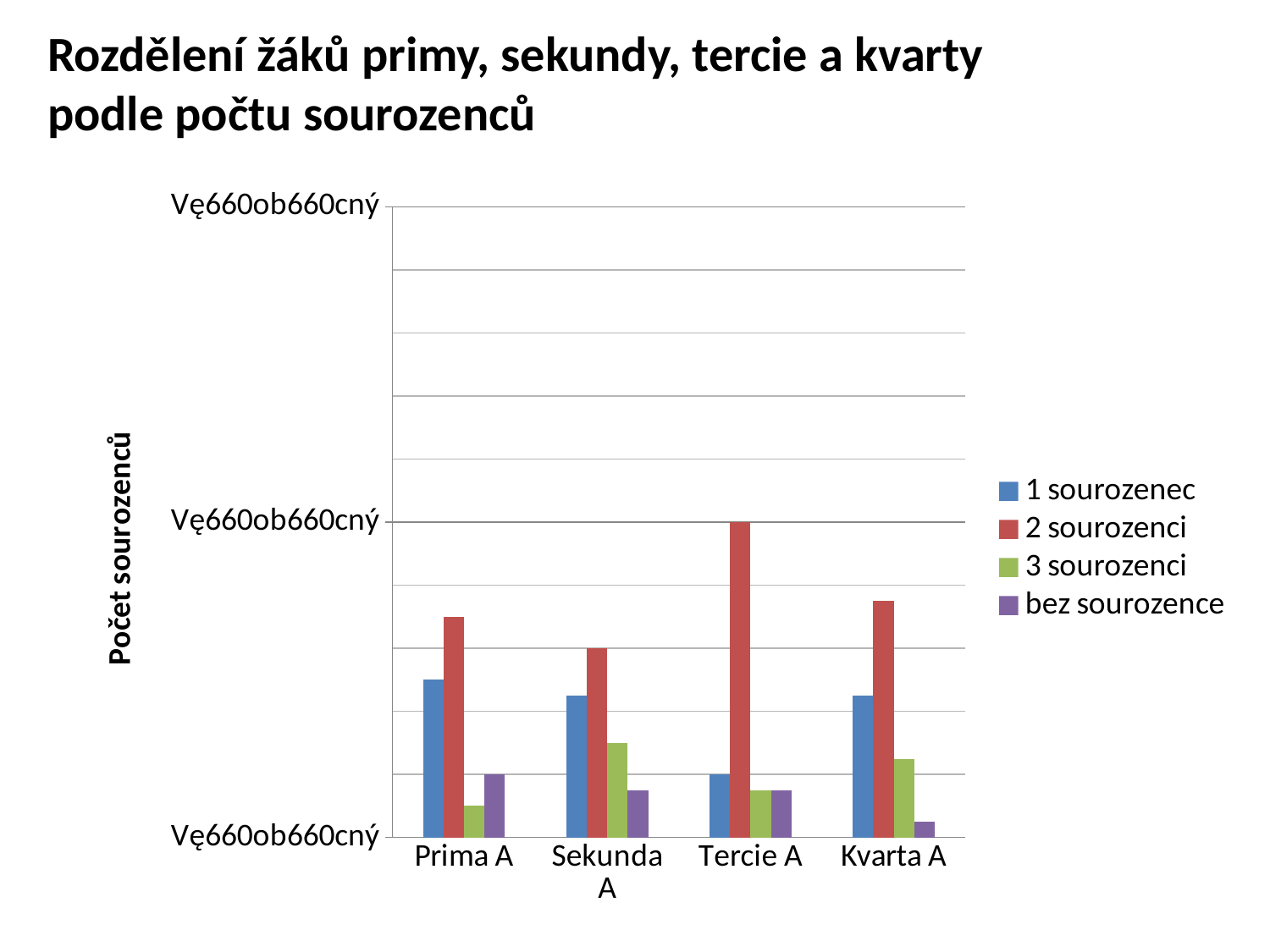
Which class has the tallest bar for '2 sourozenci'? Tercie A Which class has the shortest bar for 'bez sourozence'? Kvarta A In Prima A, which series has the shortest bar? 3 sourozenci Which class has the tallest bar for '3 sourozenci'? Sekunda A How many series does the legend list? 4 How many classes are shown on the x axis of the chart? 4 Which class has the shortest bar for '1 sourozenec'? Tercie A In Kvarta A, which is larger: '1 sourozenec' or '2 sourozenci'? 2 sourozenci In Sekunda A, which is larger: '3 sourozenci' or 'bez sourozence'? 3 sourozenci What is the title of the vertical axis? Počet sourozenců What kind of chart is shown on the slide? bar chart In Prima A, which series has the tallest bar? 2 sourozenci